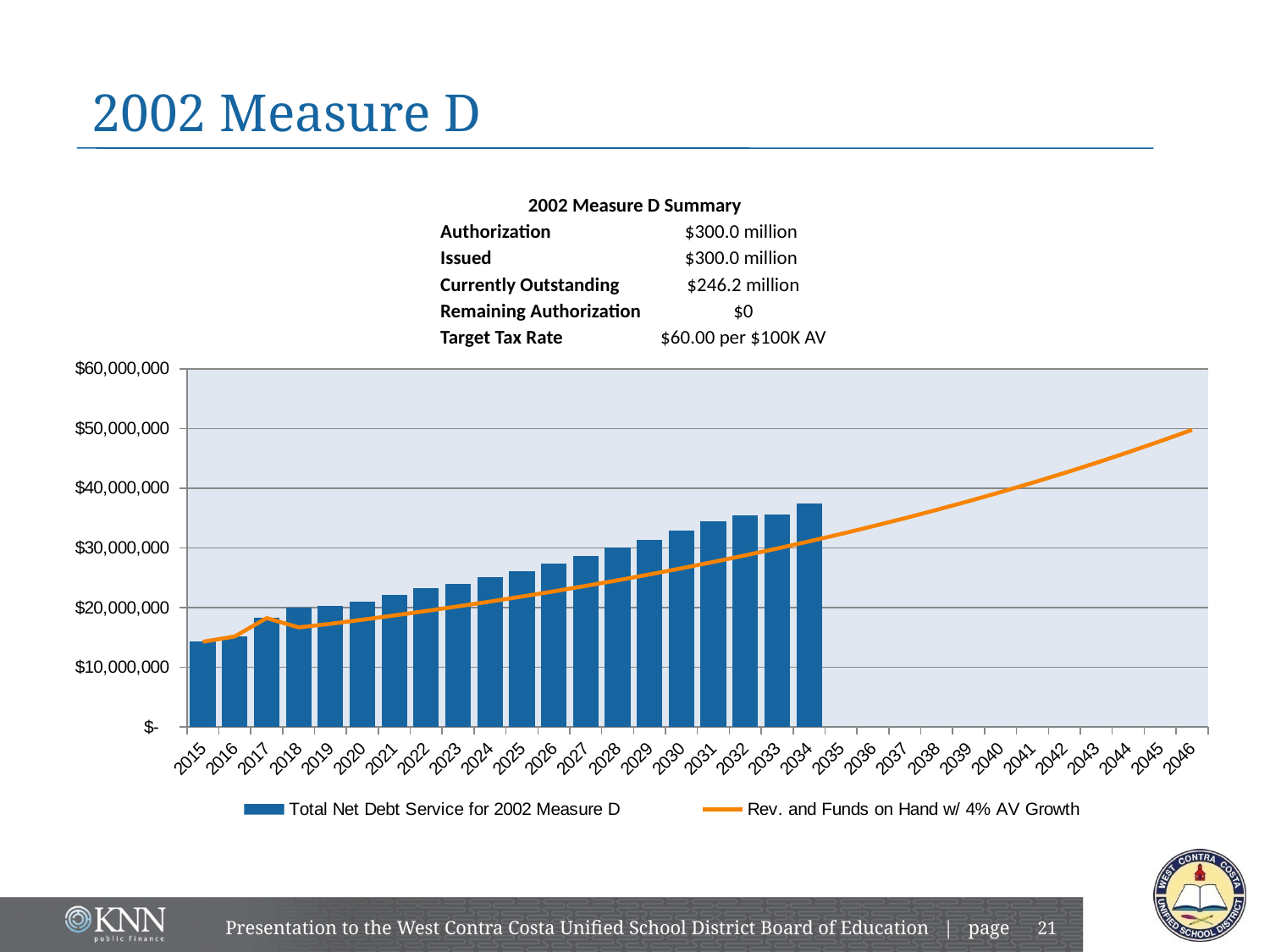
Which year has the highest bar for Total Net Debt Service for 2002 Measure D? 2034 How many years are labelled on the x axis of the chart? 32 What is the label of the line series in the chart legend? Rev. and Funds on Hand w/ 4% AV Growth Is the Total Net Debt Service bar for 2034 greater or less than $30,000,000? greater In 2034, which is higher: the Total Net Debt Service bar or the Rev. and Funds on Hand w/ 4% AV Growth line? The Total Net Debt Service bar Which year has the lowest bar for Total Net Debt Service for 2002 Measure D? 2015 What kind of chart is shown on the slide? A combined bar and line chart Is the Total Net Debt Service bar for 2015 greater or less than $20,000,000? less How many series does the chart legend list? 2 Do the Total Net Debt Service bars generally rise or fall from 2015 to 2034? Rise In how many years does the chart show a bar for Total Net Debt Service for 2002 Measure D? 20 Is the Rev. and Funds on Hand w/ 4% AV Growth line in 2046 greater or less than $40,000,000? greater